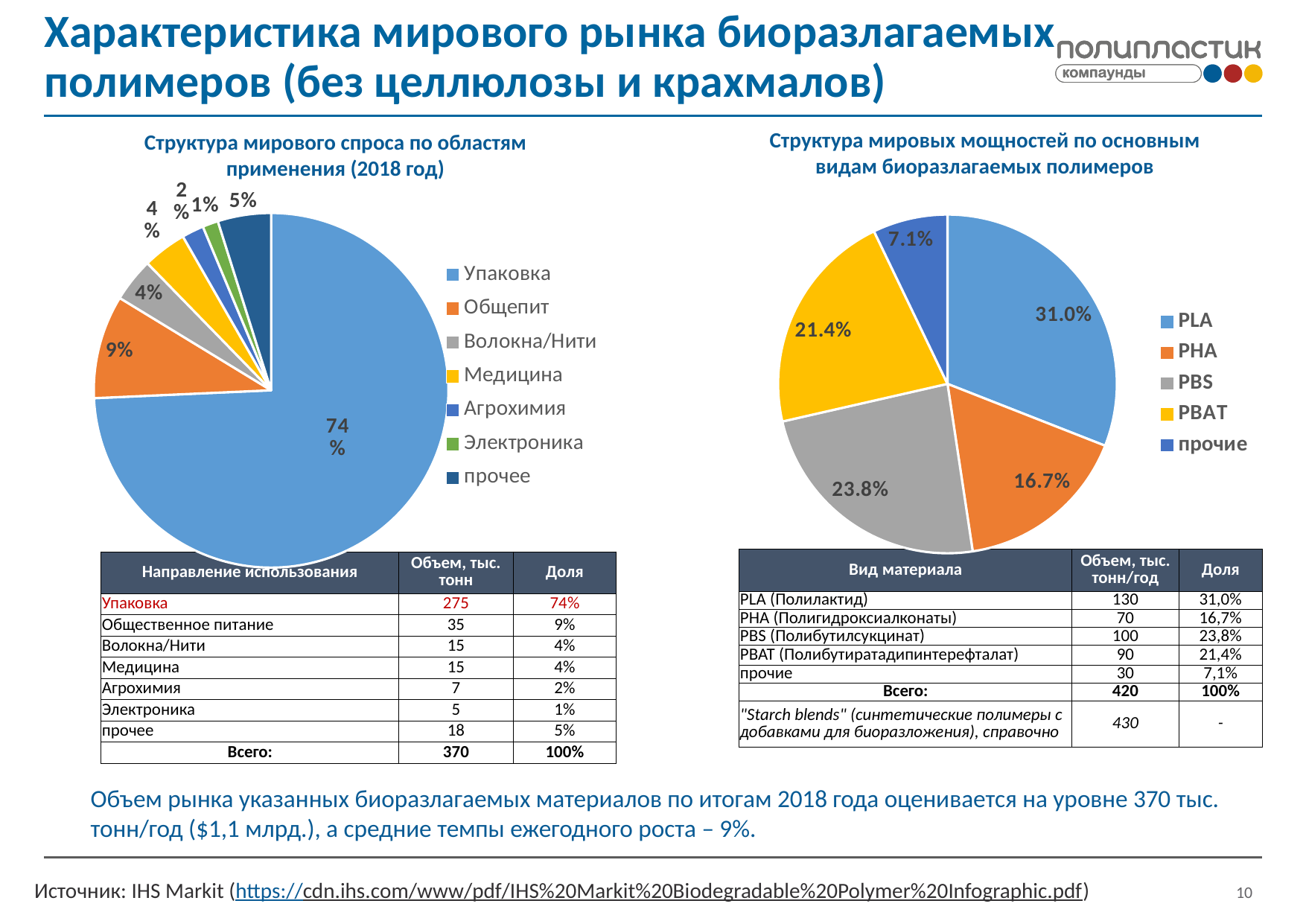
How many categories does the legend of the left pie chart (Структура мирового спроса по областям применения) list? 7 In the right pie chart (Структура мировых мощностей по основным видам биоразлагаемых полимеров), what is the difference between the shares of PLA and PHA? 14.3% What kind of chart is the left chart, 'Структура мирового спроса по областям применения (2018 год)'? pie chart In the left pie chart (Структура мирового спроса по областям применения), what share does Упаковка have? 74% In the left pie chart (Структура мирового спроса по областям применения), which category has the largest share? Упаковка In the left pie chart (Структура мирового спроса по областям применения), which category has the smallest share? Электроника In the right pie chart (Структура мировых мощностей по основным видам биоразлагаемых полимеров), what share does PLA have? 31.0% In the right pie chart (Структура мировых мощностей по основным видам биоразлагаемых полимеров), what share does PBAT have? 21.4% In the left pie chart (Структура мирового спроса по областям применения), what is the difference between the shares of Упаковка and Общепит? 65% In the right pie chart (Структура мировых мощностей по основным видам биоразлагаемых полимеров), which is larger: PBS or PHA? PBS In the left pie chart (Структура мирового спроса по областям применения), what share does Общепит have? 9% In the right pie chart (Структура мировых мощностей по основным видам биоразлагаемых полимеров), which category has the smallest share? прочие